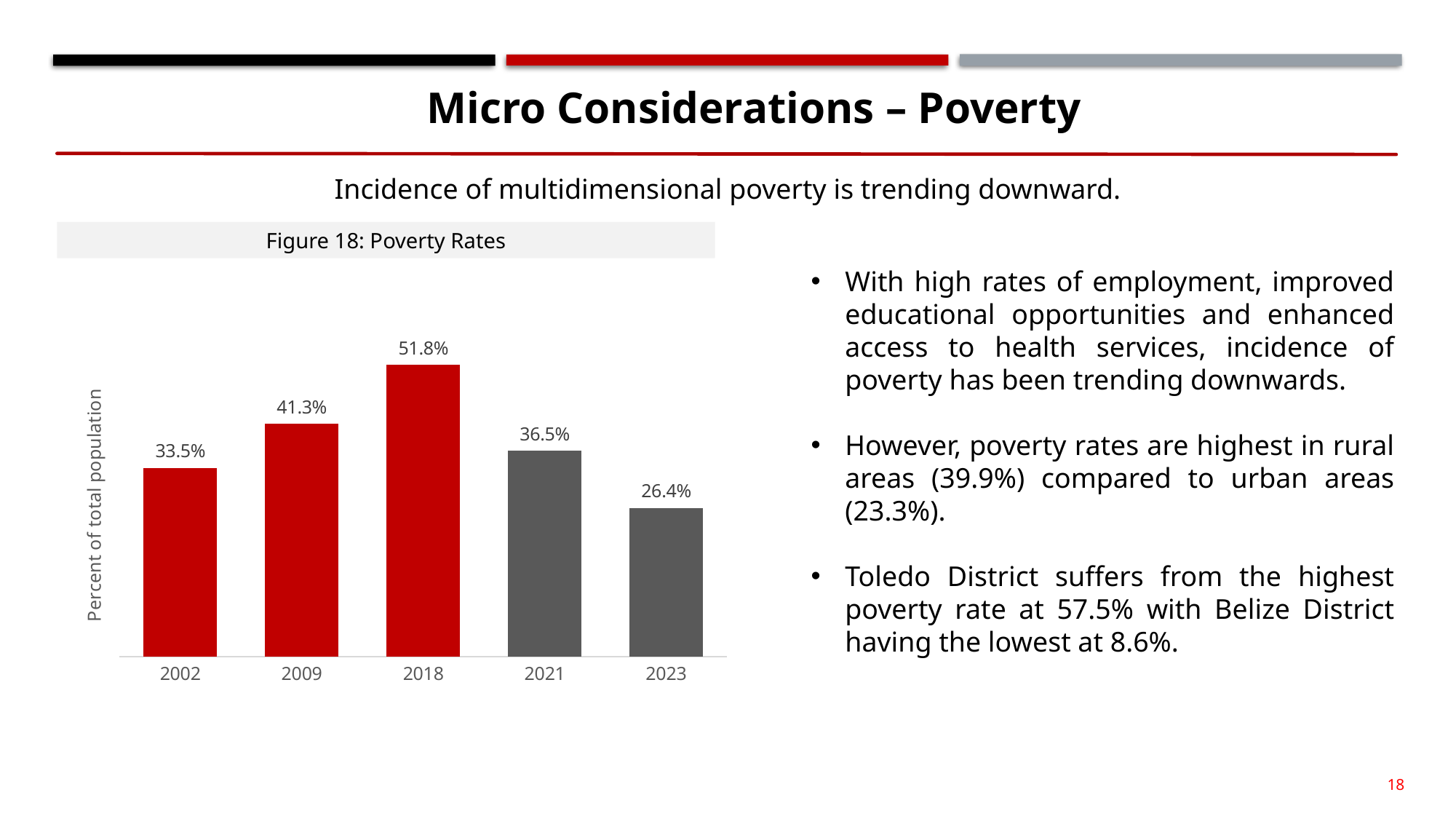
Which year has the highest poverty rate in the chart? 2018 What is the difference between the poverty rates for 2018 and 2023? 25.4% What type of chart is Figure 18? Bar chart What is the poverty rate shown for 2023? 26.4% Which year has a higher poverty rate, 2009 or 2021? 2009 Do the poverty rates rise or fall from 2018 to 2023? Fall What is the poverty rate shown for 2002? 33.5% Which year has the lowest poverty rate in the chart? 2023 What is the poverty rate shown for 2018? 51.8% How many years are shown on the x axis of the chart? 5 What is the difference between the poverty rates for 2009 and 2002? 7.8% What is the title of the chart on the slide? Figure 18: Poverty Rates